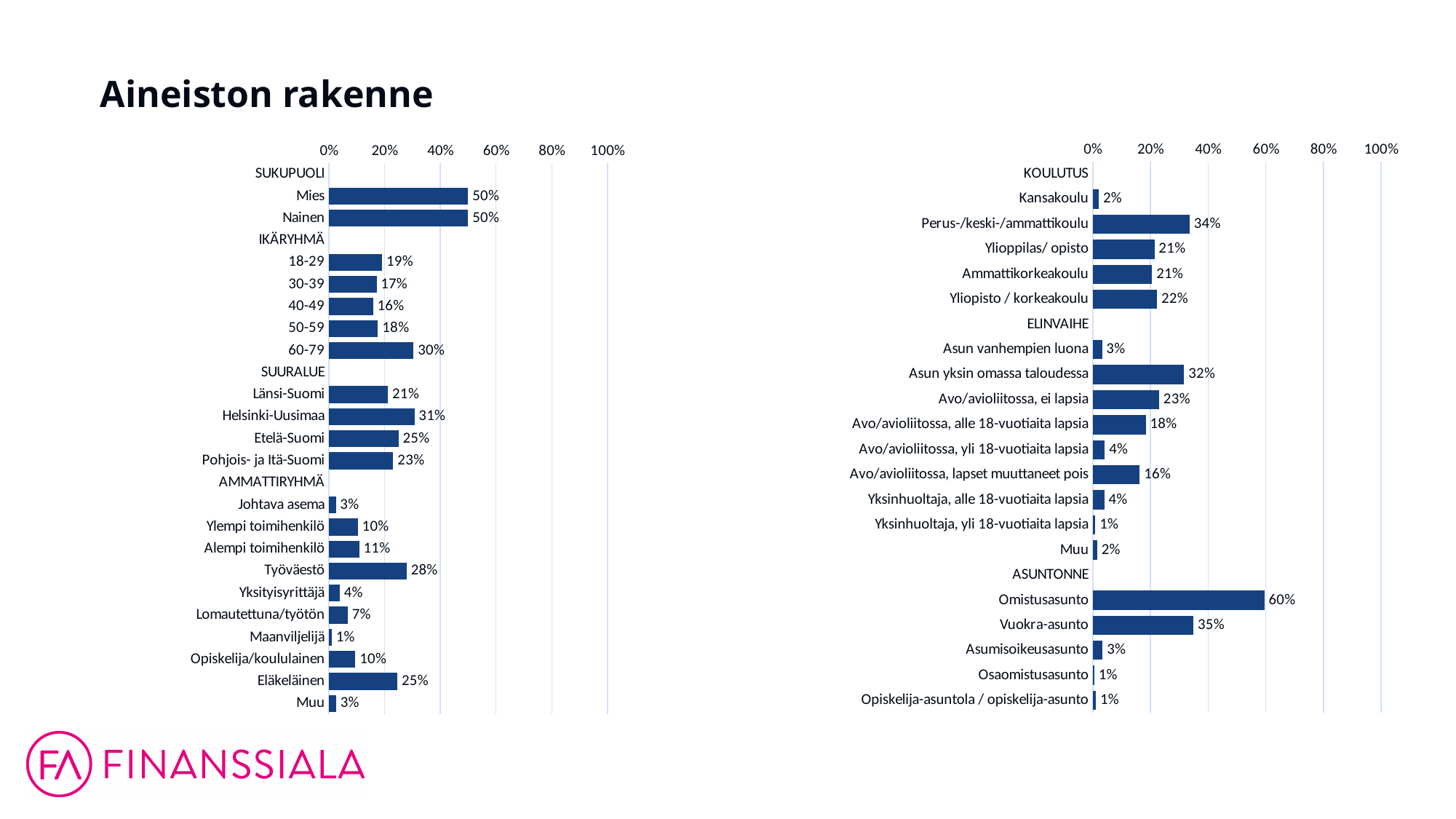
On the left chart, what is the value for Helsinki-Uusimaa? 31% On the left chart, how many categories are listed under SUURALUE? 4 On the right chart, which category in the ELINVAIHE group has the highest value? Asun yksin omassa taloudessa On the left chart, what is the value for the 60-79 age group? 30% On the left chart, which category in the AMMATTIRYHMÄ group has the highest value? Työväestö On the left chart, which is larger, Etelä-Suomi or Pohjois- ja Itä-Suomi? Etelä-Suomi On the right chart, what is the value for Omistusasunto? 60% What type of chart is shown on the left side of the slide? Bar chart On the right chart, what is the difference between Omistusasunto and Vuokra-asunto? 25% On the right chart, is the value for Asun yksin omassa taloudessa greater or less than 20%? greater On the left chart, which category in the IKÄRYHMÄ group has the lowest value? 40-49 On the right chart, what is the value for Perus-/keski-/ammattikoulu? 34%